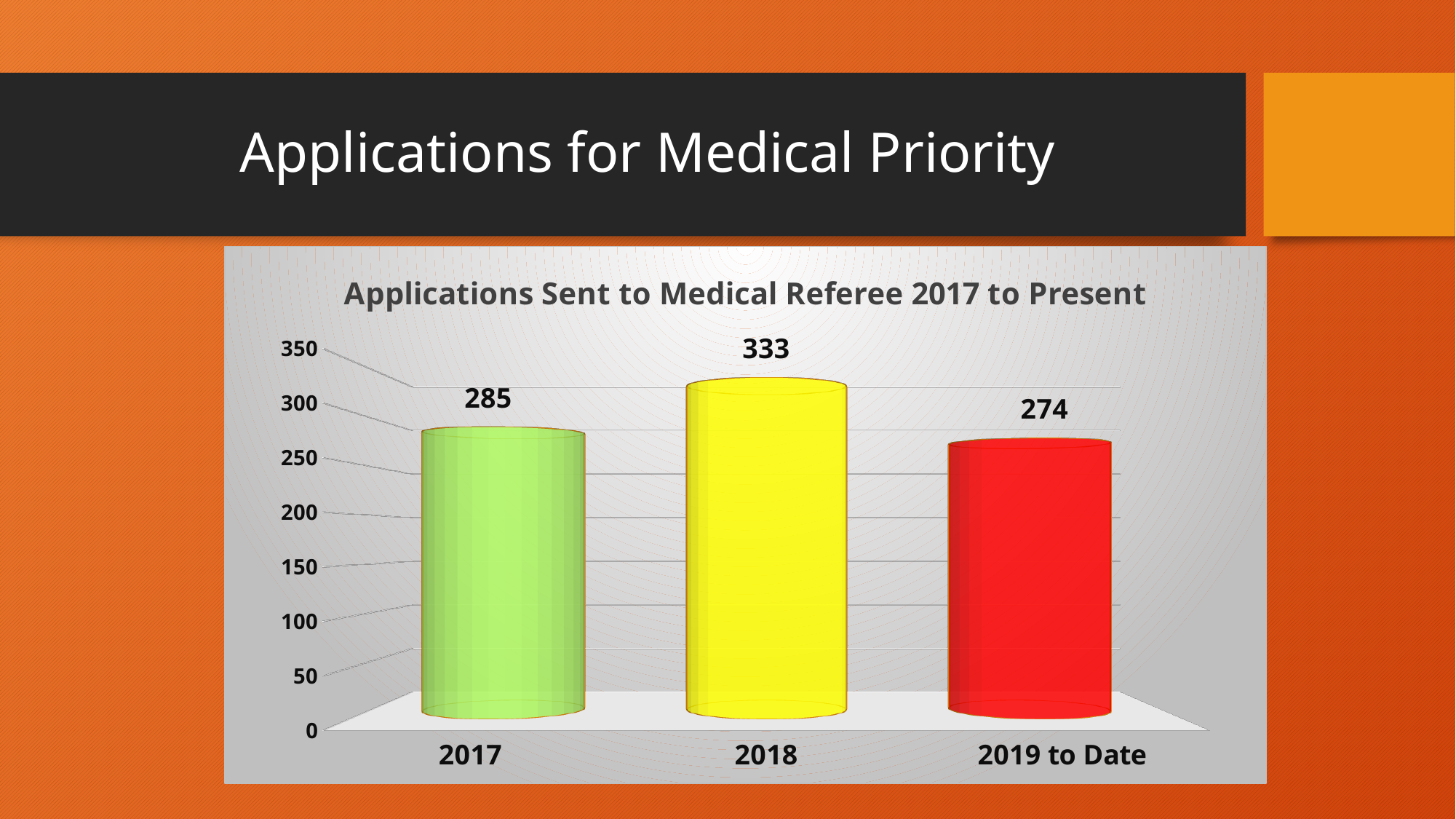
Which category has the highest value? 2018 What kind of chart is shown on the slide? bar chart What is the difference between the values for 2018 and 2017? 48 Which is larger, the value for 2017 or the value for 2019 to Date? 2017 Is the value for 2018 greater or less than 300? greater What is the value for 2018? 333 Which category has the lowest value? 2019 to Date What is the title of the chart? Applications Sent to Medical Referee 2017 to Present What is the difference between the values for 2017 and 2019 to Date? 11 What is the value for 2019 to Date? 274 How many categories are shown on the x axis? 3 What is the value for 2017? 285